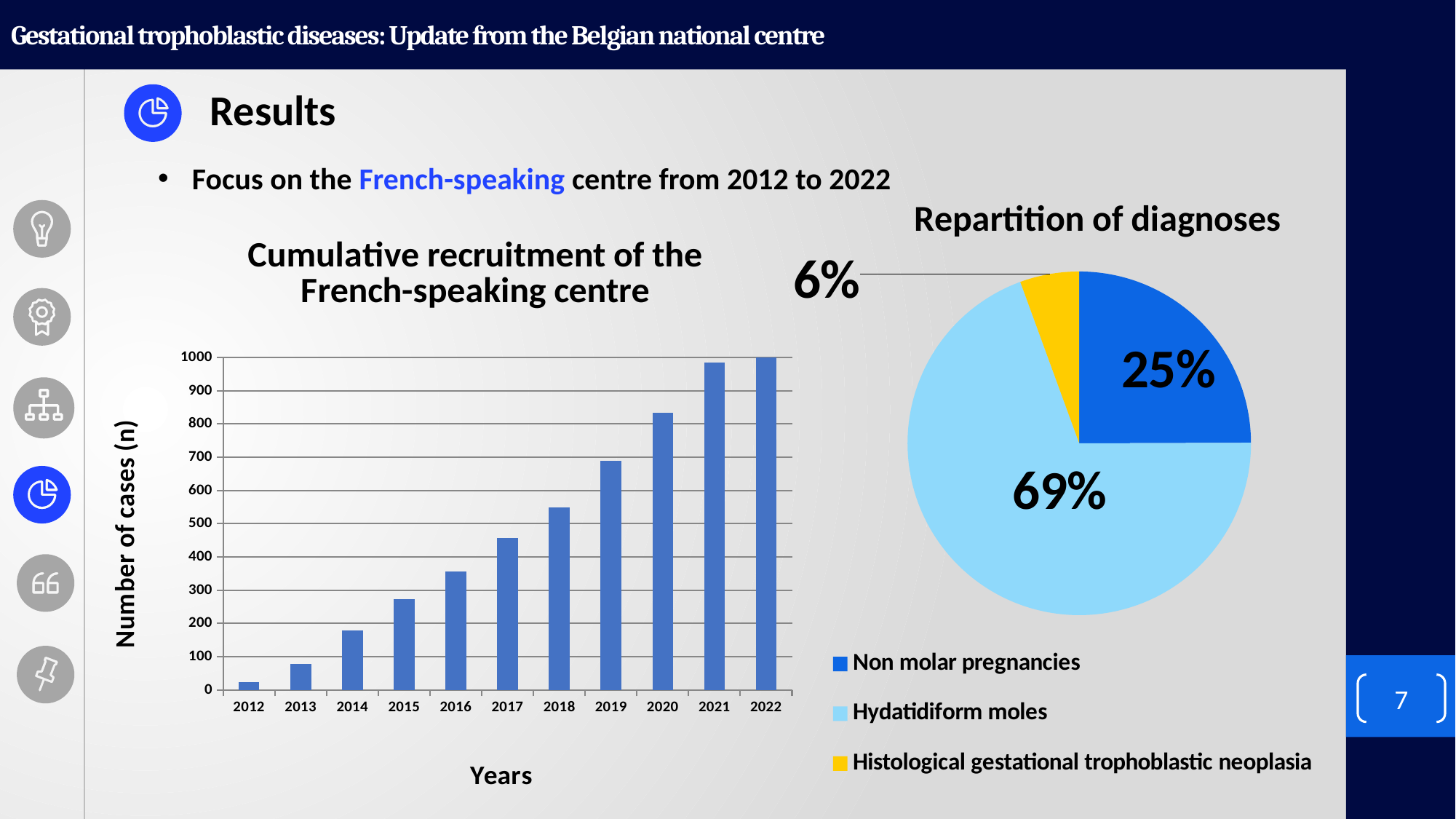
In the 'Cumulative recruitment of the French-speaking centre' chart, is the value for 2015 greater or less than 300? less In the 'Repartition of diagnoses' pie chart, which category has the largest share? Hydatidiform moles In the 'Repartition of diagnoses' pie chart, what share is Histological gestational trophoblastic neoplasia? 6% In the 'Repartition of diagnoses' pie chart, which category has the smallest share? Histological gestational trophoblastic neoplasia In the 'Cumulative recruitment of the French-speaking centre' chart, do the values rise or fall from 2012 to 2022? rise In the 'Cumulative recruitment of the French-speaking centre' chart, is the value for 2019 greater or less than 600? greater How many years are shown on the x axis of the 'Cumulative recruitment of the French-speaking centre' chart? 11 What kind of chart is 'Cumulative recruitment of the French-speaking centre'? bar chart In the 'Repartition of diagnoses' pie chart, what is the difference in percentage points between Hydatidiform moles and Non molar pregnancies? 44 How many categories does the legend of the 'Repartition of diagnoses' pie chart list? 3 In the 'Repartition of diagnoses' pie chart, what share is Non molar pregnancies? 25% In the 'Repartition of diagnoses' pie chart, what share is Hydatidiform moles? 69%